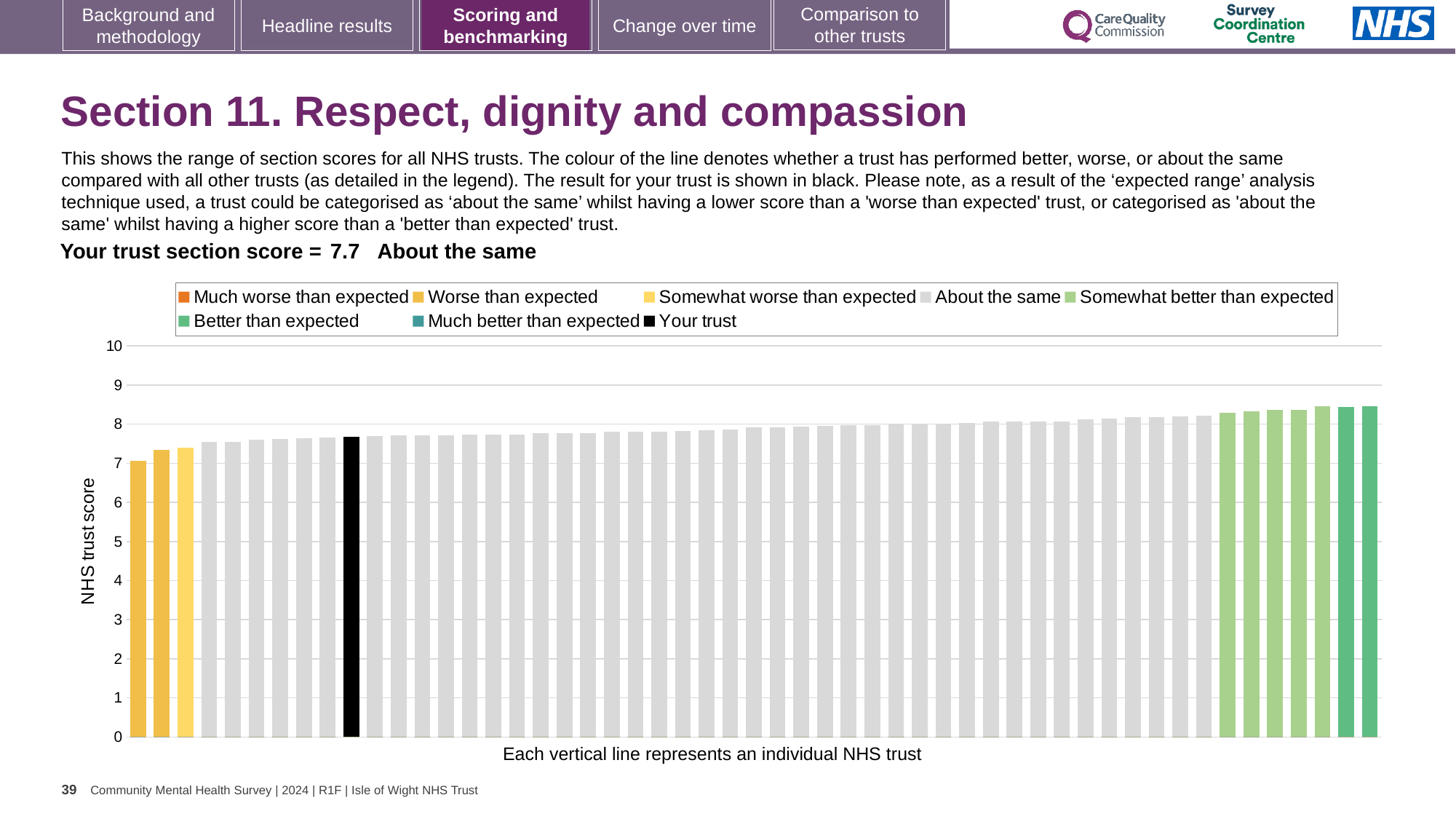
Is the value for your trust (the black bar) greater or less than 7? greater Which category is your trust placed in for Section 11? About the same What is the highest value shown on the vertical axis? 10 What kind of chart is shown on the slide? bar chart Is the value of the leftmost bar greater or less than 8? less Which is larger, the leftmost bar or the rightmost bar? the rightmost bar What is the label on the vertical axis of the chart? NHS trust score Is the value of the rightmost bar greater or less than 8? greater What is the section score for your trust shown on the slide? 7.7 How many entries does the chart legend list? 8 How many bars are coloured as 'Worse than expected'? 2 Do the bar values rise or fall from left to right across the chart? rise